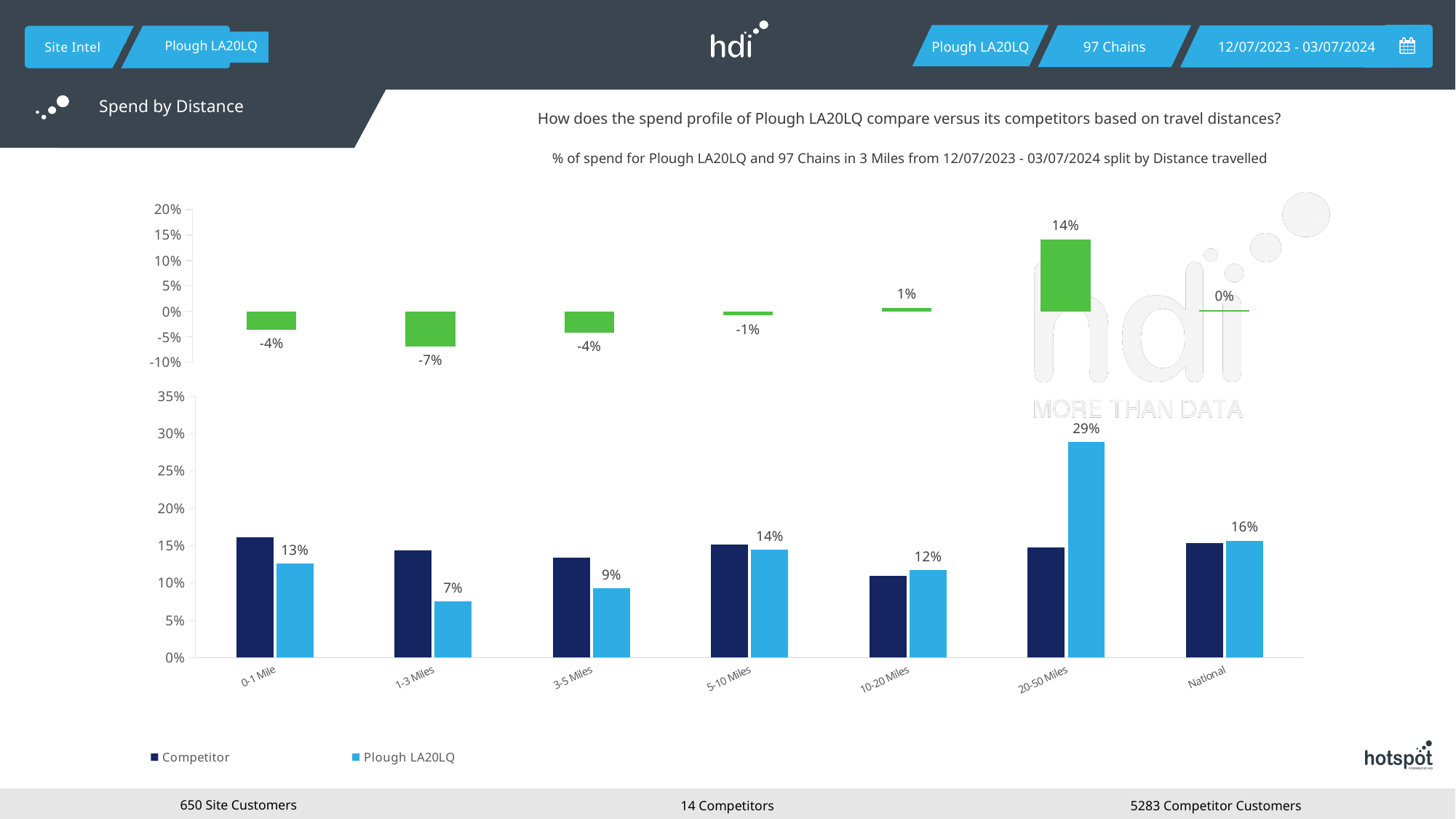
In the bottom chart, which category has the highest Plough LA20LQ value? 20-50 Miles In the top chart, which category has the highest value? 20-50 Miles In the top chart, which category has the lowest value? 1-3 Miles In the bottom chart, what is the Plough LA20LQ value for 0-1 Mile? 13% How many categories are shown on the x axis of the bottom chart? 7 How many series does the legend of the bottom chart list? 2 In the top chart, what is the value for 20-50 Miles? 14% In the bottom chart, what is the difference between the Plough LA20LQ values for 20-50 Miles and National? 13% In the top chart, what is the value for 1-3 Miles? -7% In the bottom chart, what is the Plough LA20LQ value for 20-50 Miles? 29% In the bottom chart, is the Competitor value for 0-1 Mile greater or less than 15%? greater In the bottom chart, which category has the lowest Plough LA20LQ value? 1-3 Miles